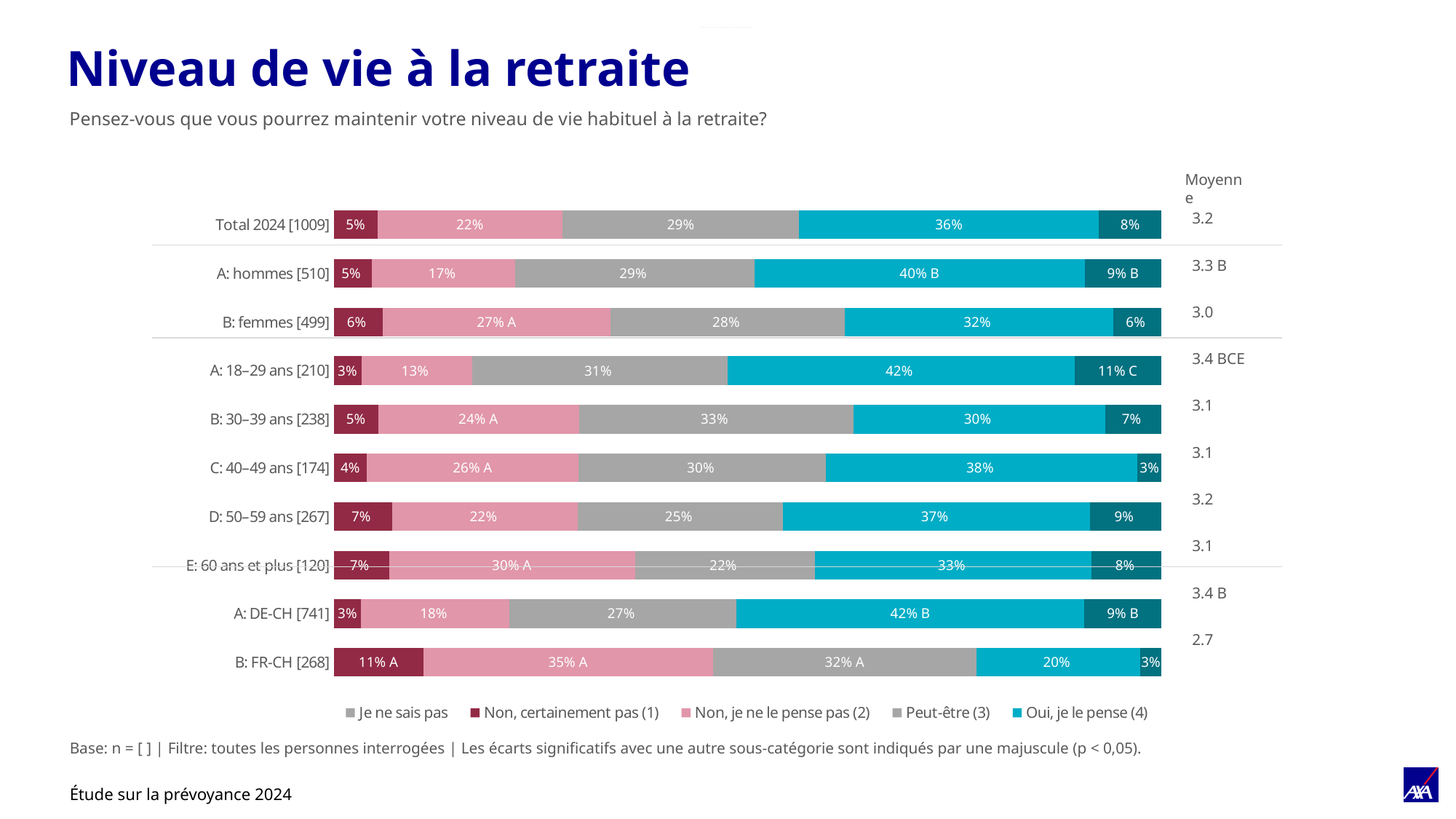
What percentage of Total 2024 [1009] answered "Oui, je le pense (4)"? 36% Which has a larger "Peut-être (3)" share, B: 30–39 ans [238] or D: 50–59 ans [267]? B: 30–39 ans [238] Which category has the highest "Non, certainement pas (1)" share? B: FR-CH [268] Which category has the lowest "Oui, je le pense (4)" share? B: FR-CH [268] What kind of chart is shown on the slide? Stacked bar chart Which category has the lowest Moyenne value? B: FR-CH [268] How many categories (bars) are shown in the chart? 10 What is the difference in the "Oui, je le pense (4)" share between A: hommes [510] and B: femmes [499]? 8 percentage points What is the "Peut-être (3)" value for B: femmes [499]? 28% What is the Moyenne value shown for Total 2024 [1009]? 3.2 What is the "Non, certainement pas (1)" value for D: 50–59 ans [267]? 7% How many series does the legend list? 5